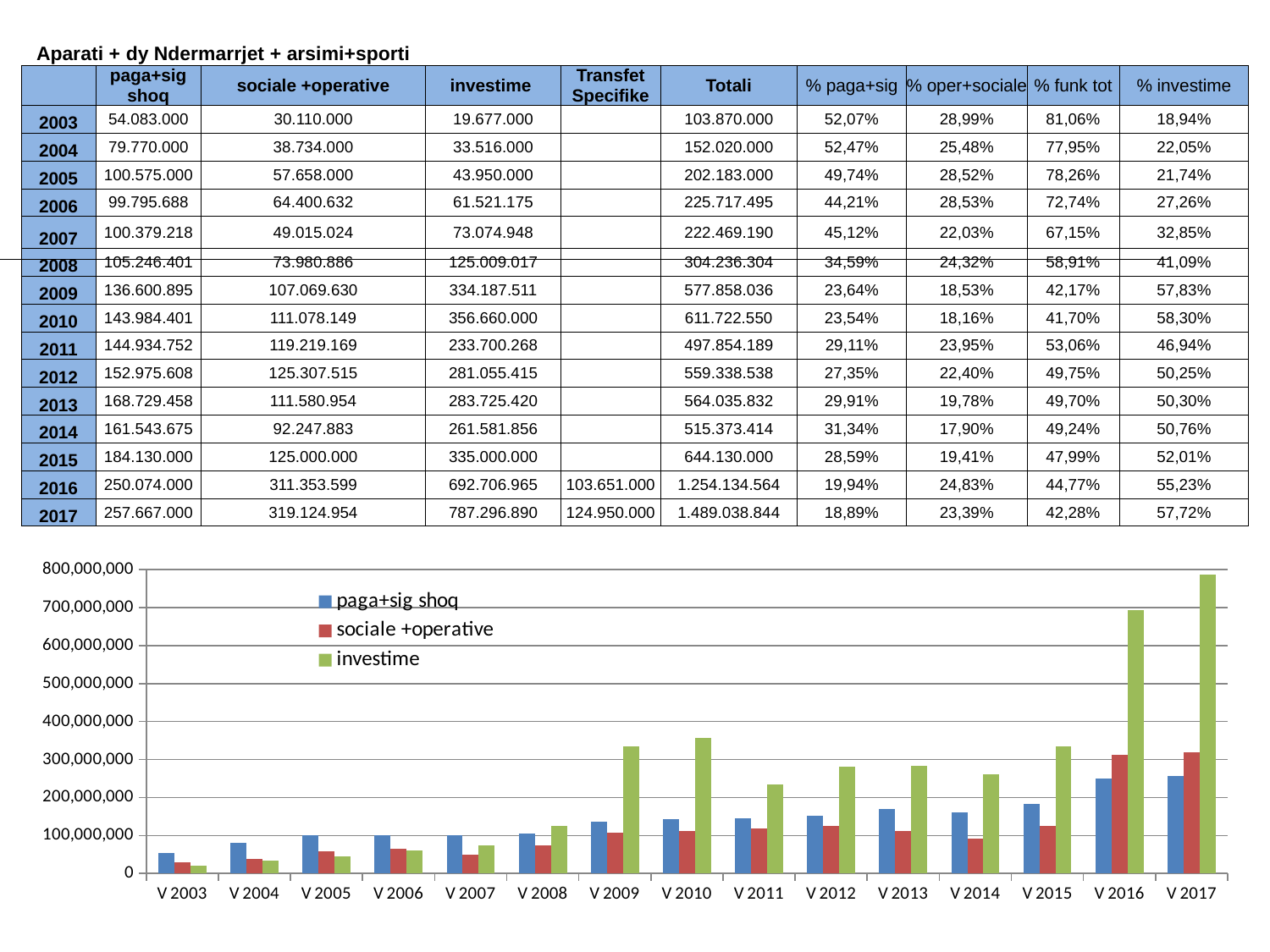
Is the investime value for V 2017 greater or less than 700,000,000? greater How many year categories are shown on the x axis of the chart? 15 Is the paga+sig shoq value for V 2003 greater or less than 100,000,000? less How many series does the chart legend list? 3 For V 2009, which is larger: investime or paga+sig shoq? investime For V 2004, which is larger: paga+sig shoq or sociale +operative? paga+sig shoq Which colour represents the investime series in the chart? green What kind of chart is shown on the slide? bar chart In which year is the investime bar the shortest? V 2003 In which year is the investime bar the tallest? V 2017 Is the investime value for V 2016 greater or less than 600,000,000? greater Does the paga+sig shoq series generally rise or fall from V 2003 to V 2017? rise